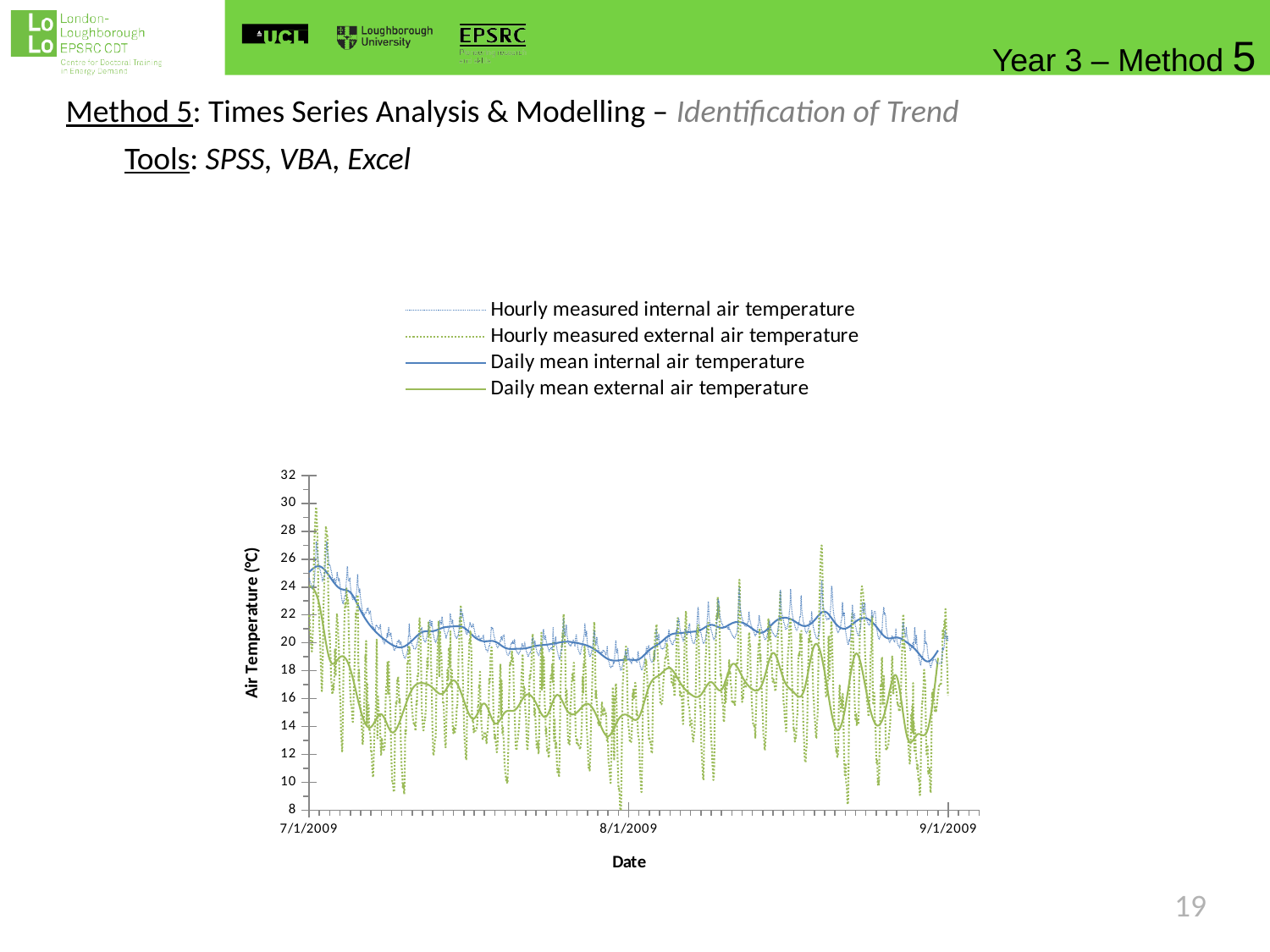
What is the label of the chart's horizontal axis? Date How many series does the chart's legend list? 4 Which series is drawn as a solid blue line in the chart? Daily mean internal air temperature Which is higher at 8/1/2009, the daily mean internal air temperature or the daily mean external air temperature? Daily mean internal air temperature Is the daily mean internal air temperature at 8/1/2009 greater or less than 16? greater How many date labels are shown on the chart's horizontal axis? 3 Is the daily mean external air temperature at 8/1/2009 greater or less than 16? less Is the daily mean internal air temperature at 7/1/2009 greater or less than 24? greater Does the daily mean internal air temperature rise or fall between 7/1/2009 and mid-July 2009? fall What is the highest value shown on the chart's vertical axis? 32 What kind of chart is shown on the slide? line chart